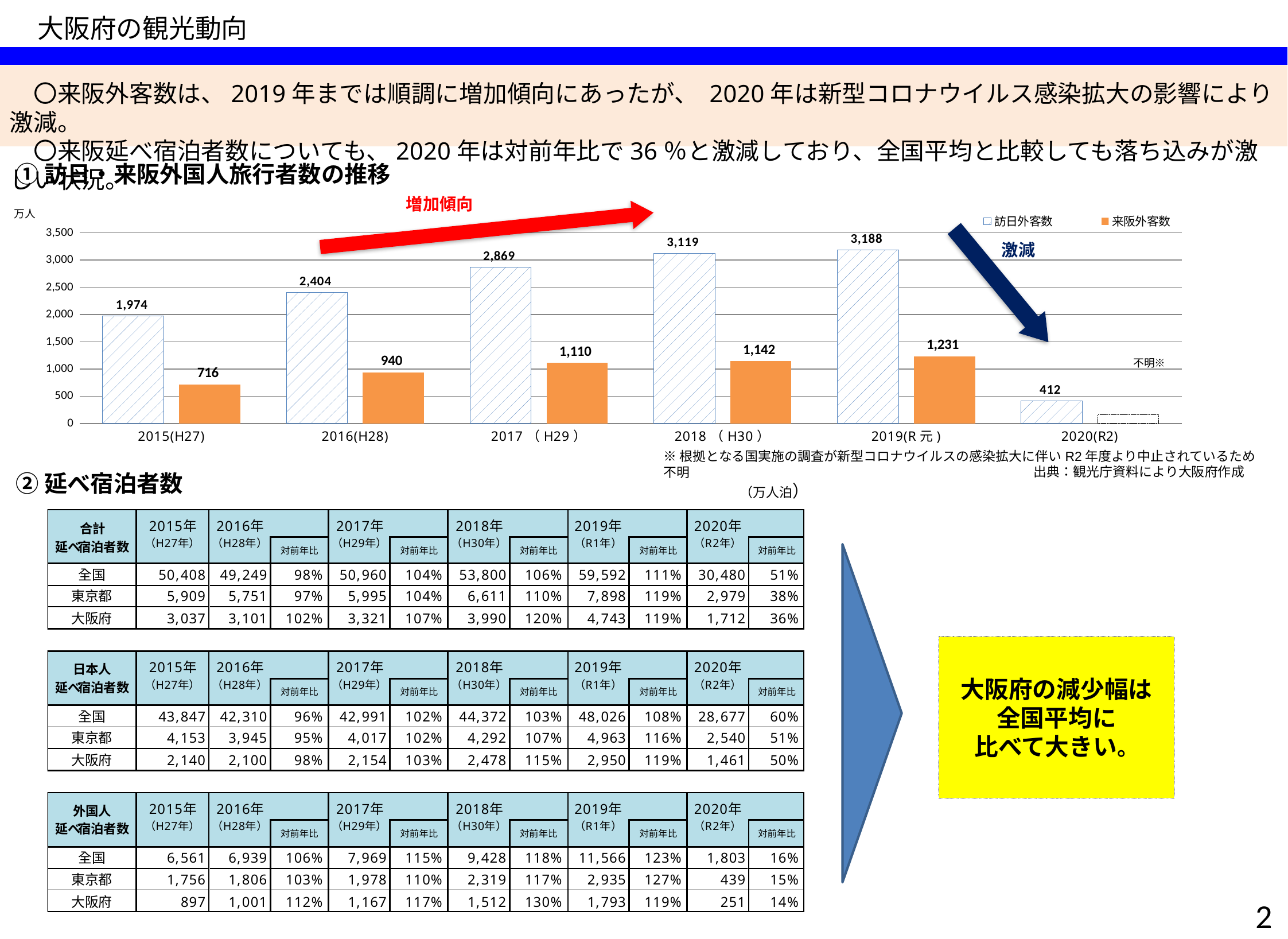
In which year is 来阪外客数 lowest among the years with a printed value? 2015(H27) What kind of chart is used to show 訪日・来阪外国人旅行者数の推移? bar chart What is the value of 来阪外客数 for 2017(H29)? 1,110 Is the value of 訪日外客数 for 2016(H28) greater or less than 2,000? greater In which year is 訪日外客数 highest? 2019(R元) What is the value of 訪日外客数 for 2019(R元)? 3,188 How many series does the chart legend list? 2 Which is larger: 来阪外客数 in 2016(H28) or 来阪外客数 in 2019(R元)? 2019(R元) What is the value of 訪日外客数 for 2020(R2)? 412 Does 来阪外客数 rise or fall from 2015(H27) to 2019(R元)? rise How many years are shown on the x axis of the chart? 6 What is the difference between 訪日外客数 and 来阪外客数 in 2018(H30)? 1,977